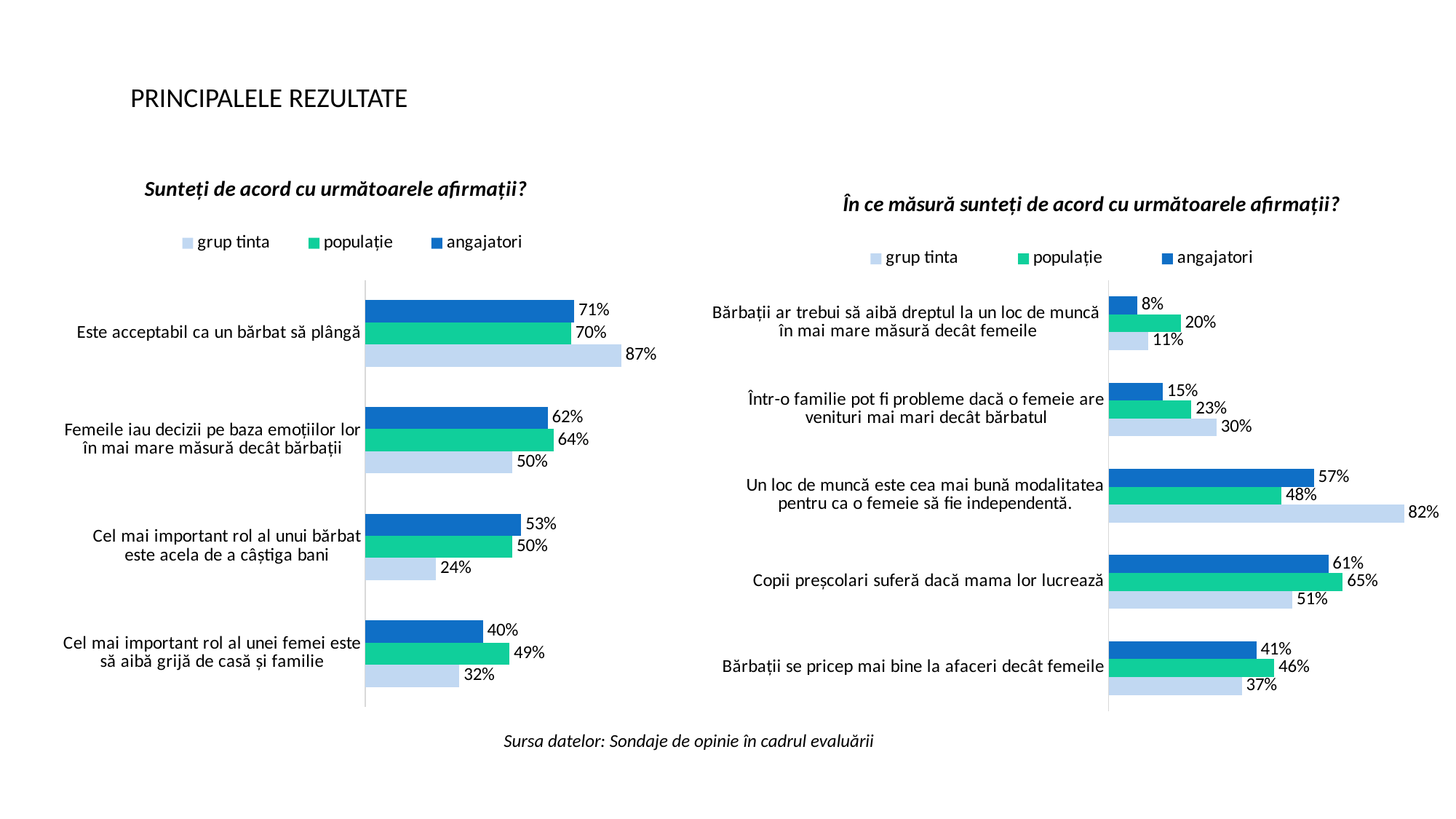
In the left chart titled "Sunteți de acord cu următoarele afirmații?", what is the value for "grup tinta" for "Este acceptabil ca un bărbat să plângă"? 87% In the right chart titled "În ce măsură sunteți de acord cu următoarele afirmații?", what is the value for "angajatori" for "Bărbații ar trebui să aibă dreptul la un loc de muncă în mai mare măsură decât femeile"? 8% In the left chart titled "Sunteți de acord cu următoarele afirmații?", how many categories are shown? 4 In the right chart titled "În ce măsură sunteți de acord cu următoarele afirmații?", how many series does the legend list? 3 In the right chart titled "În ce măsură sunteți de acord cu următoarele afirmații?", which category has the highest value for "populație"? Copii preșcolari suferă dacă mama lor lucrează In the left chart titled "Sunteți de acord cu următoarele afirmații?", what is the value for "angajatori" for "Cel mai important rol al unei femei este să aibă grijă de casă și familie"? 40% In the right chart titled "În ce măsură sunteți de acord cu următoarele afirmații?", what is the difference between the "populație" and "grup tinta" values for "Bărbații se pricep mai bine la afaceri decât femeile"? 9% In the left chart titled "Sunteți de acord cu următoarele afirmații?", what is the difference between the "populație" and "grup tinta" values for "Cel mai important rol al unui bărbat este acela de a câștiga bani"? 26% In the right chart titled "În ce măsură sunteți de acord cu următoarele afirmații?", what is the value for "grup tinta" for "Un loc de muncă este cea mai bună modalitatea pentru ca o femeie să fie independentă."? 82% In the right chart titled "În ce măsură sunteți de acord cu următoarele afirmații?", for "Într-o familie pot fi probleme dacă o femeie are venituri mai mari decât bărbatul", which is larger: the "grup tinta" value or the "angajatori" value? grup tinta What kind of chart is the right chart titled "În ce măsură sunteți de acord cu următoarele afirmații?"? Bar chart In the left chart titled "Sunteți de acord cu următoarele afirmații?", which category has the lowest value for "grup tinta"? Cel mai important rol al unui bărbat este acela de a câștiga bani